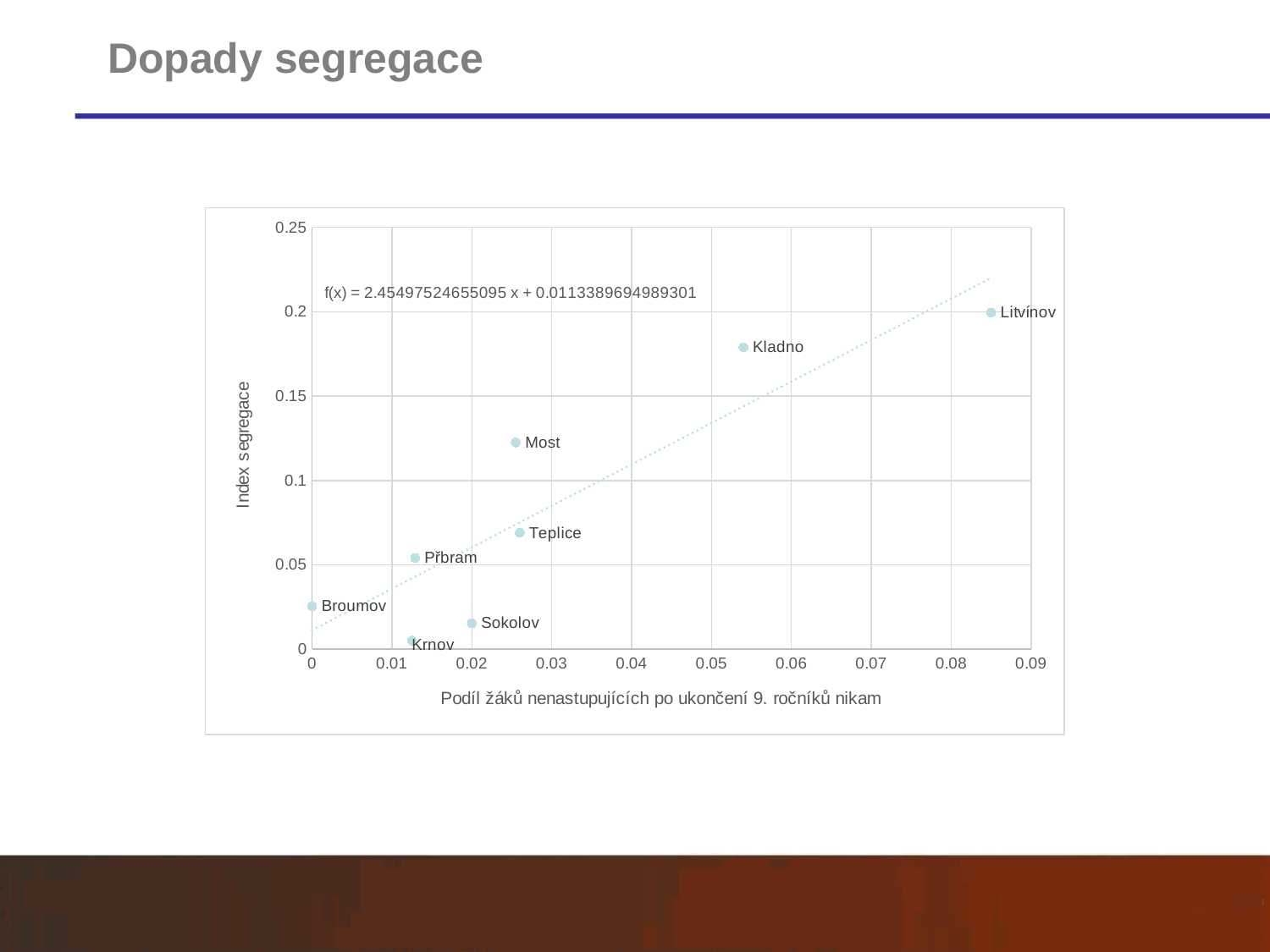
What kind of chart is shown on the slide? scatter chart Which town has the lowest Index segregace? Krnov What is the title of the vertical axis? Index segregace Which has a higher Index segregace, Kladno or Most? Kladno Does the fitted trend line rise or fall as the x-axis value increases? rises Is the Index segregace for Teplice greater or less than 0.1? less Is the x-axis value (Podíl žáků nenastupujících po ukončení 9. ročníků nikam) for Litvínov greater or less than 0.08? greater Is the Index segregace for Most greater or less than 0.1? greater How many labelled data points are plotted on the chart? 8 Which town has the highest Index segregace? Litvínov Which has a higher Index segregace, Příbram or Sokolov? Příbram